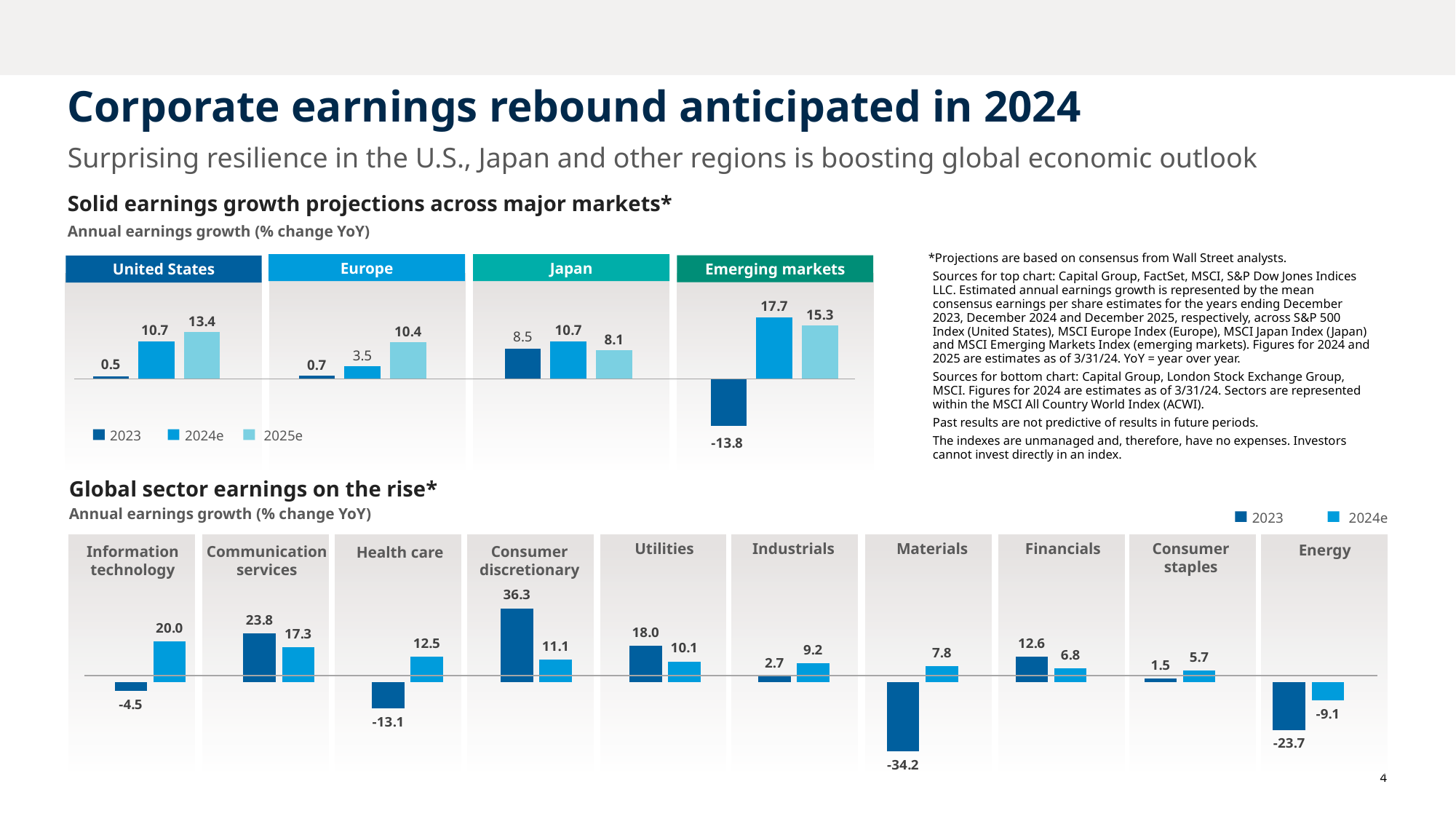
In the bottom chart 'Global sector earnings on the rise', which sector has the lowest 2023 value? Materials In the bottom chart 'Global sector earnings on the rise', what is the 2023 value for Consumer discretionary? 36.3 In the bottom chart 'Global sector earnings on the rise', how many sectors are shown? 10 In the top chart 'Solid earnings growth projections across major markets', what is the difference between the 2025e and 2023 values for Europe? 9.7 In the bottom chart 'Global sector earnings on the rise', what is the difference between the 2023 and 2024e values for Communication services? 6.5 In the top chart 'Solid earnings growth projections across major markets', how many series does the legend list? 3 In the bottom chart 'Global sector earnings on the rise', is the 2024e value for Utilities or for Industrials larger? Utilities In the top chart 'Solid earnings growth projections across major markets', which region has the highest 2025e value? Emerging markets In the top chart 'Solid earnings growth projections across major markets', what is the 2024e value for the United States? 10.7 What kind of chart is the bottom chart 'Global sector earnings on the rise'? Bar chart In the top chart 'Solid earnings growth projections across major markets', what is the 2023 value for Emerging markets? -13.8 In the bottom chart 'Global sector earnings on the rise', which sector has the highest 2024e value? Information technology